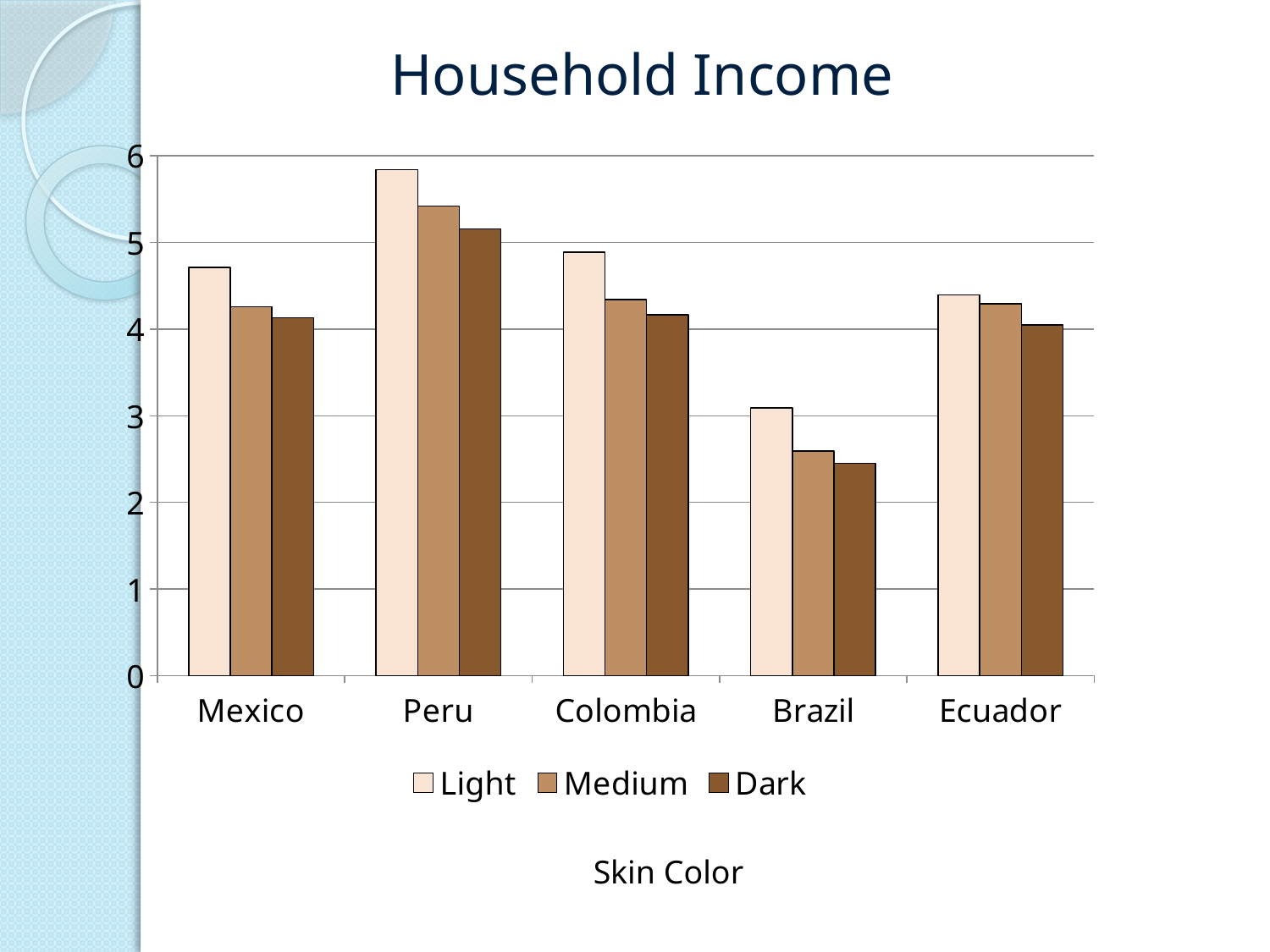
Which is larger, the Light value for Mexico or the Light value for Ecuador? Mexico What is the x-axis label of the Household Income chart? Skin Color What kind of chart is shown on the slide? bar chart How many countries are shown on the x axis of the Household Income chart? 5 Which country has the highest Light bar in the Household Income chart? Peru How many series does the legend of the Household Income chart list? 3 Is the Medium value for Colombia greater or less than 4? greater Within each country, which series has the tallest bar in the Household Income chart? Light Which country has the lowest Dark bar in the Household Income chart? Brazil Is the Light value for Peru greater or less than 5? greater Is the Light value for Brazil greater or less than 4? less